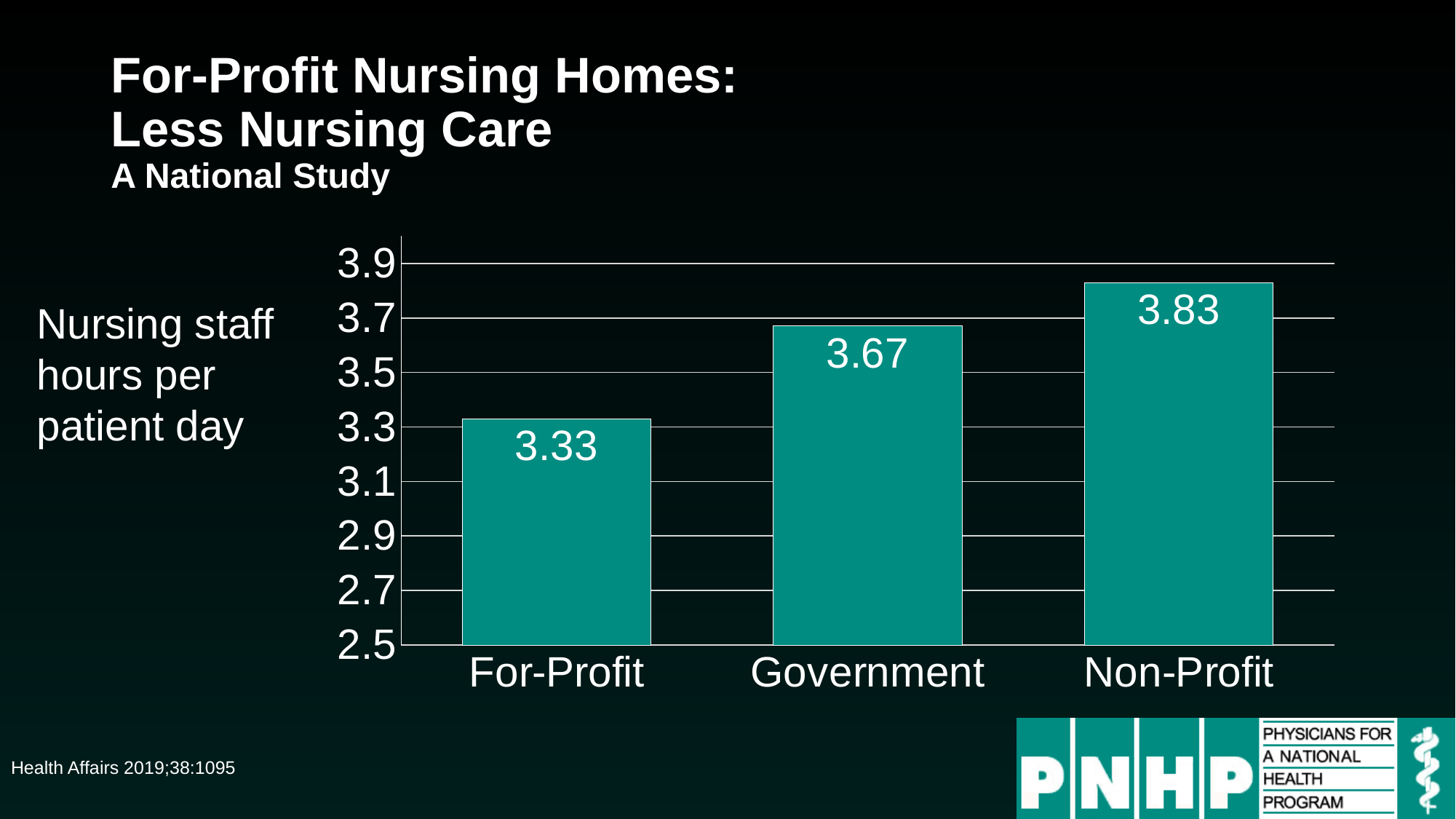
What is the difference between the Government and For-Profit values? 0.34 Which is larger, the value for Government or the value for For-Profit? Government What kind of chart is shown on the slide? bar chart What is the value for For-Profit nursing homes? 3.33 Which category has the highest nursing staff hours per patient day? Non-Profit What is the value for Non-Profit nursing homes? 3.83 What is the difference between the Non-Profit and For-Profit values? 0.5 What is the value for Government nursing homes? 3.67 How many categories are shown on the x axis? 3 Do the values rise or fall from left to right across the categories? rise Is the value for Government greater or less than 3.5? greater Which category has the lowest nursing staff hours per patient day? For-Profit